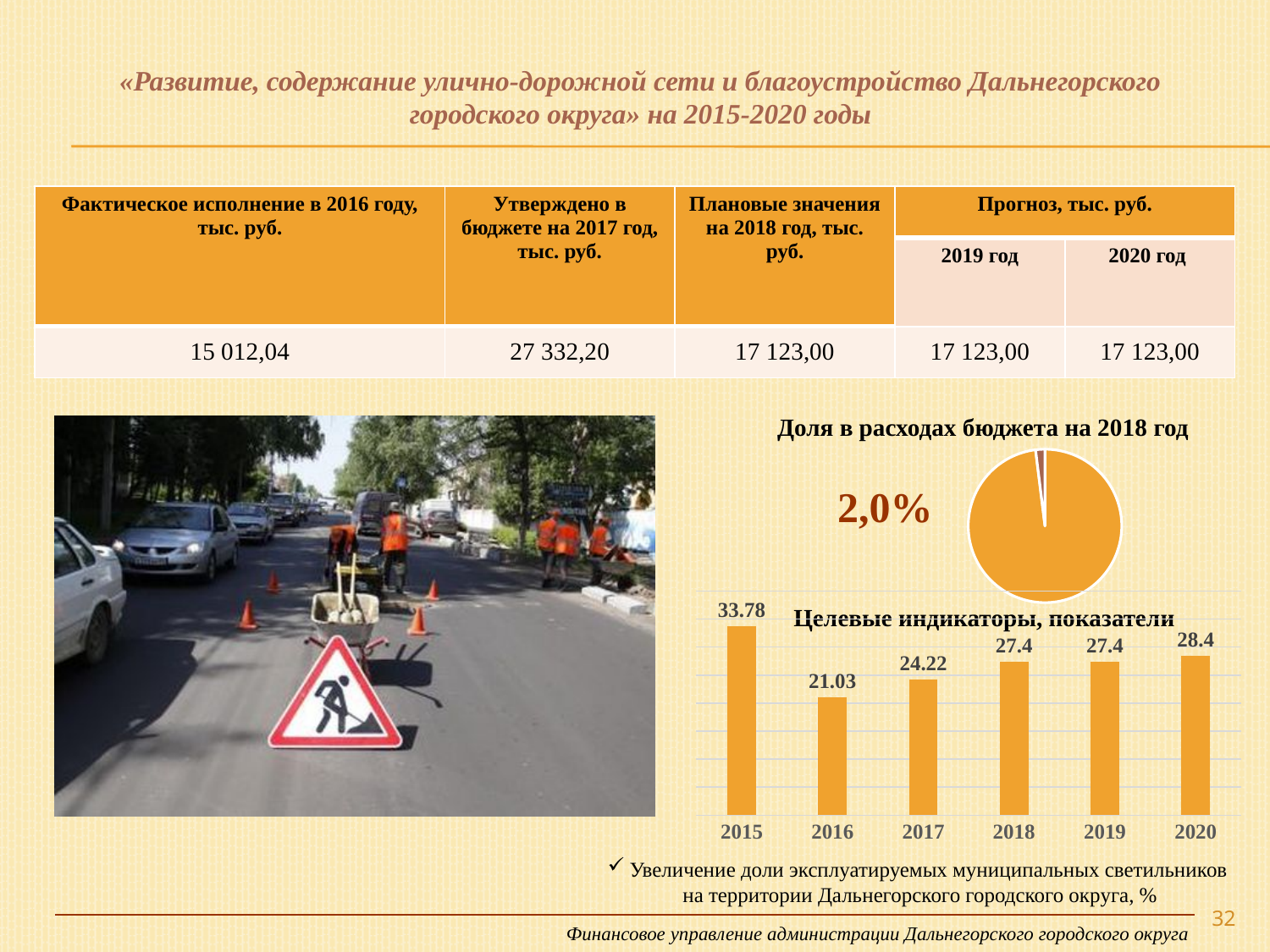
What kind of chart is 'Целевые индикаторы, показатели'? bar chart How many years are shown in the bar chart 'Целевые индикаторы, показатели'? 6 In the bar chart 'Целевые индикаторы, показатели', what is the value for 2016? 21.03 In the bar chart 'Целевые индикаторы, показатели', what is the value for 2017? 24.22 In the bar chart 'Целевые индикаторы, показатели', what is the value for 2015? 33.78 In the bar chart 'Целевые индикаторы, показатели', do the values rise or fall from 2016 to 2020? rise In the pie chart 'Доля в расходах бюджета на 2018 год', what share is shown for the programme? 2,0% In the bar chart 'Целевые индикаторы, показатели', which year has the lowest value? 2016 In the bar chart 'Целевые индикаторы, показатели', which year has the highest value? 2015 In the bar chart 'Целевые индикаторы, показатели', which is larger, the value for 2017 or the value for 2020? 2020 In the bar chart 'Целевые индикаторы, показатели', what is the difference between the values for 2015 and 2016? 12.75 In the bar chart 'Целевые индикаторы, показатели', what is the value for 2020? 28.4